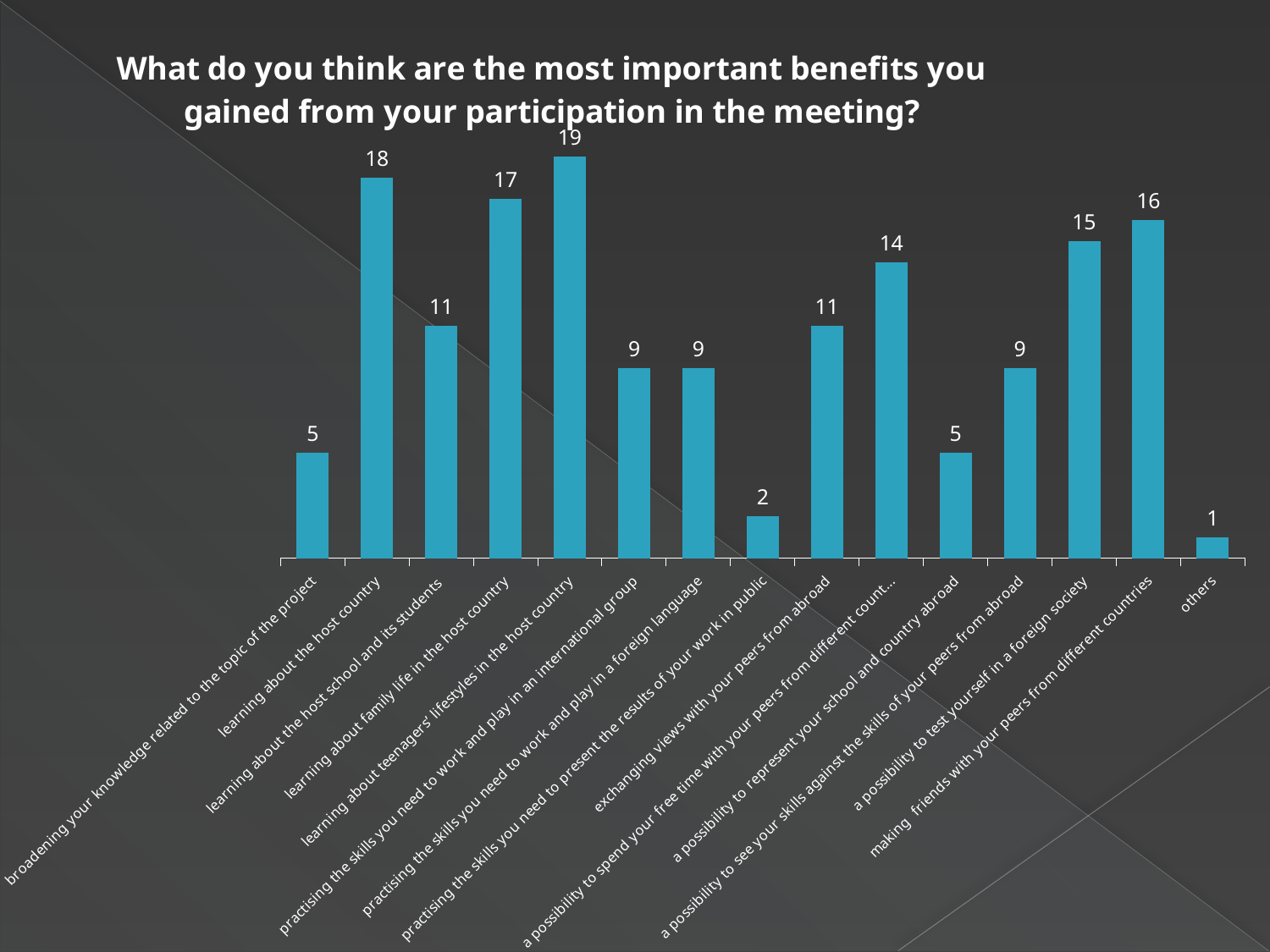
What is the value for "a possibility to test yourself in a foreign society"? 15 What is the value for "others"? 1 What is the value for "learning about the host country"? 18 What kind of chart is shown on the slide? bar chart What is the value for "making friends with your peers from different countries"? 16 What is the title of the chart? What do you think are the most important benefits you gained from your participation in the meeting? Which category has the lowest value? others What is the difference between the values for "learning about the host country" and "learning about family life in the host country"? 1 What is the difference between the values for "exchanging views with your peers from abroad" and "practising the skills you need to present the results of your work in public"? 9 Which category has the highest value? learning about teenagers' lifestyles in the host country Which is larger: the value for "a possibility to represent your school and country abroad" or the value for "a possibility to see your skills against the skills of your peers from abroad"? a possibility to see your skills against the skills of your peers from abroad How many categories are shown on the x axis? 15